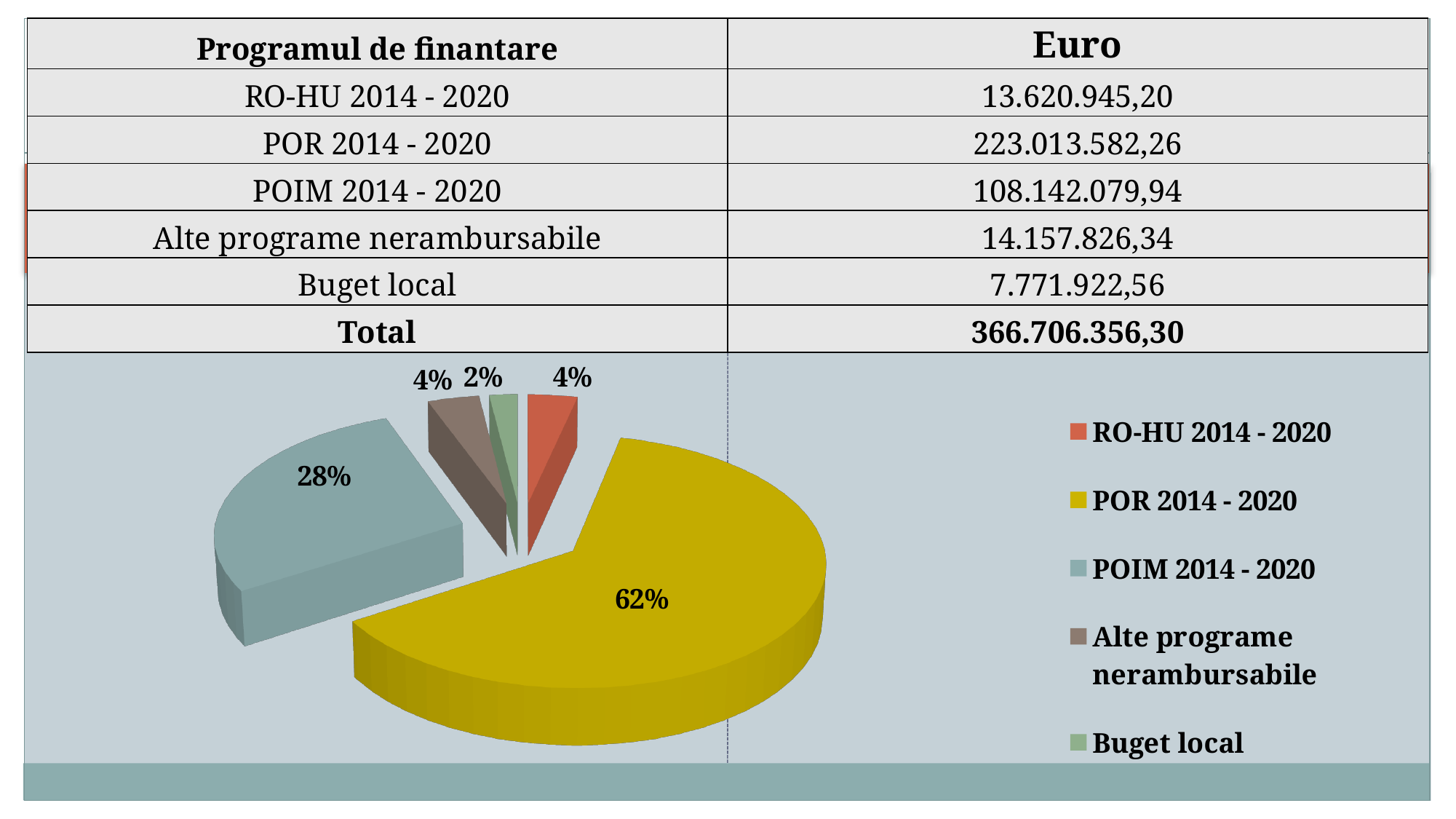
What colour is the POR 2014 - 2020 slice in the pie chart? yellow What share of the pie does RO-HU 2014 - 2020 represent? 4% What kind of chart is shown on the slide? pie chart What is the difference in percentage points between the POR 2014 - 2020 slice and the POIM 2014 - 2020 slice? 34 percentage points What share of the pie does POIM 2014 - 2020 represent? 28% What share of the pie does Buget local represent? 2% How many slices does the pie chart have? 5 Which slice is larger, POIM 2014 - 2020 or Alte programe nerambursabile? POIM 2014 - 2020 Which category has the smallest slice of the pie? Buget local Which category has the largest slice of the pie? POR 2014 - 2020 Which legend entry is listed last in the pie chart's legend? Buget local